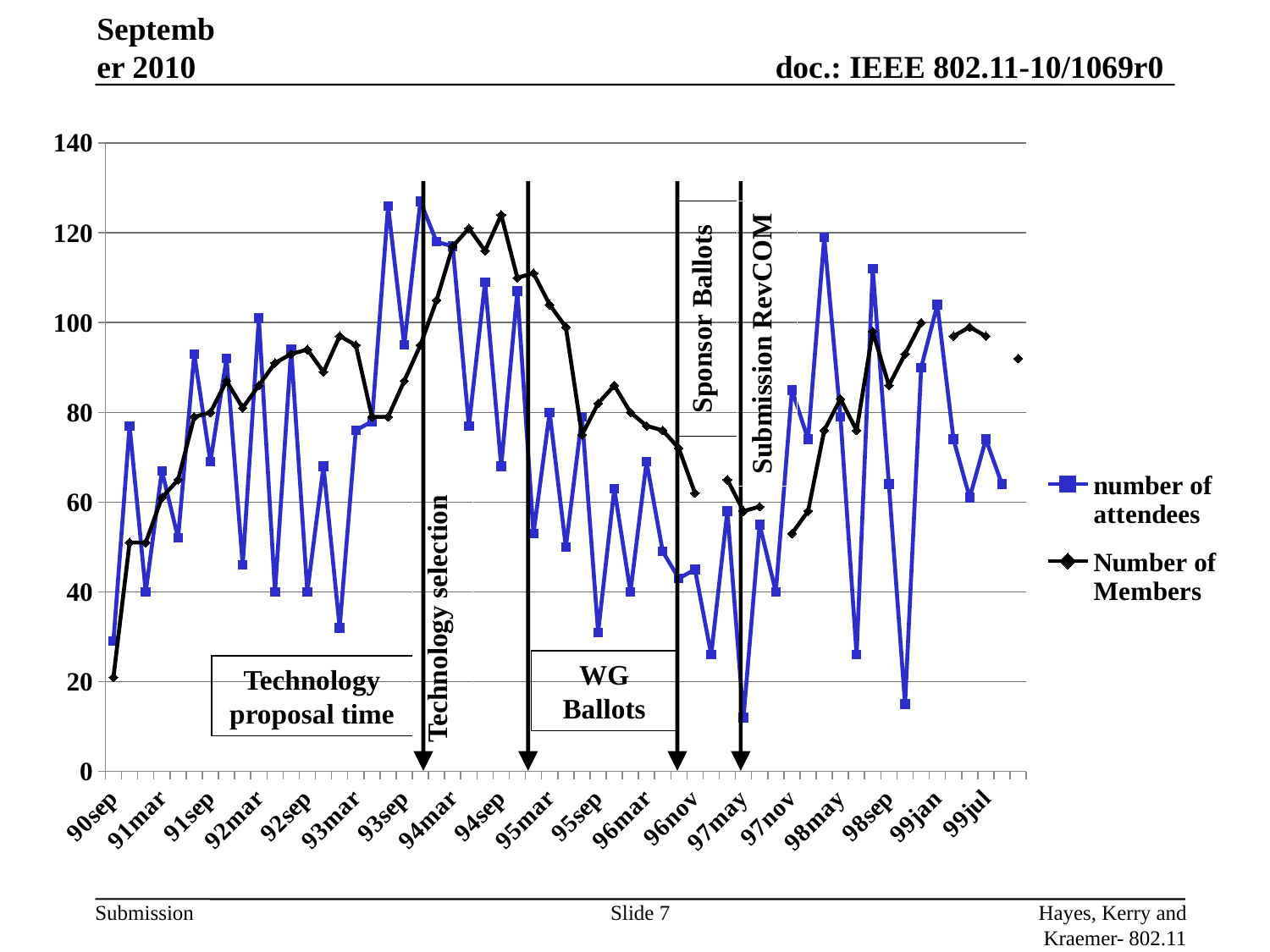
Is the value for number of attendees at 90sep greater or less than 40? less Is the value for Number of Members at 90sep greater or less than 40? less How many series does the legend list? 2 Is the lowest value reached by number of attendees greater or less than 20? less What are the two series named in the legend? number of attendees; Number of Members Does the Number of Members series generally rise or fall between 90sep and 94sep? rise At 90sep, which series has the larger value, number of attendees or Number of Members? number of attendees Does the Number of Members series generally rise or fall between 94sep and 96nov? fall What kind of chart is shown on the slide? line chart Which series is drawn in blue with square markers? number of attendees